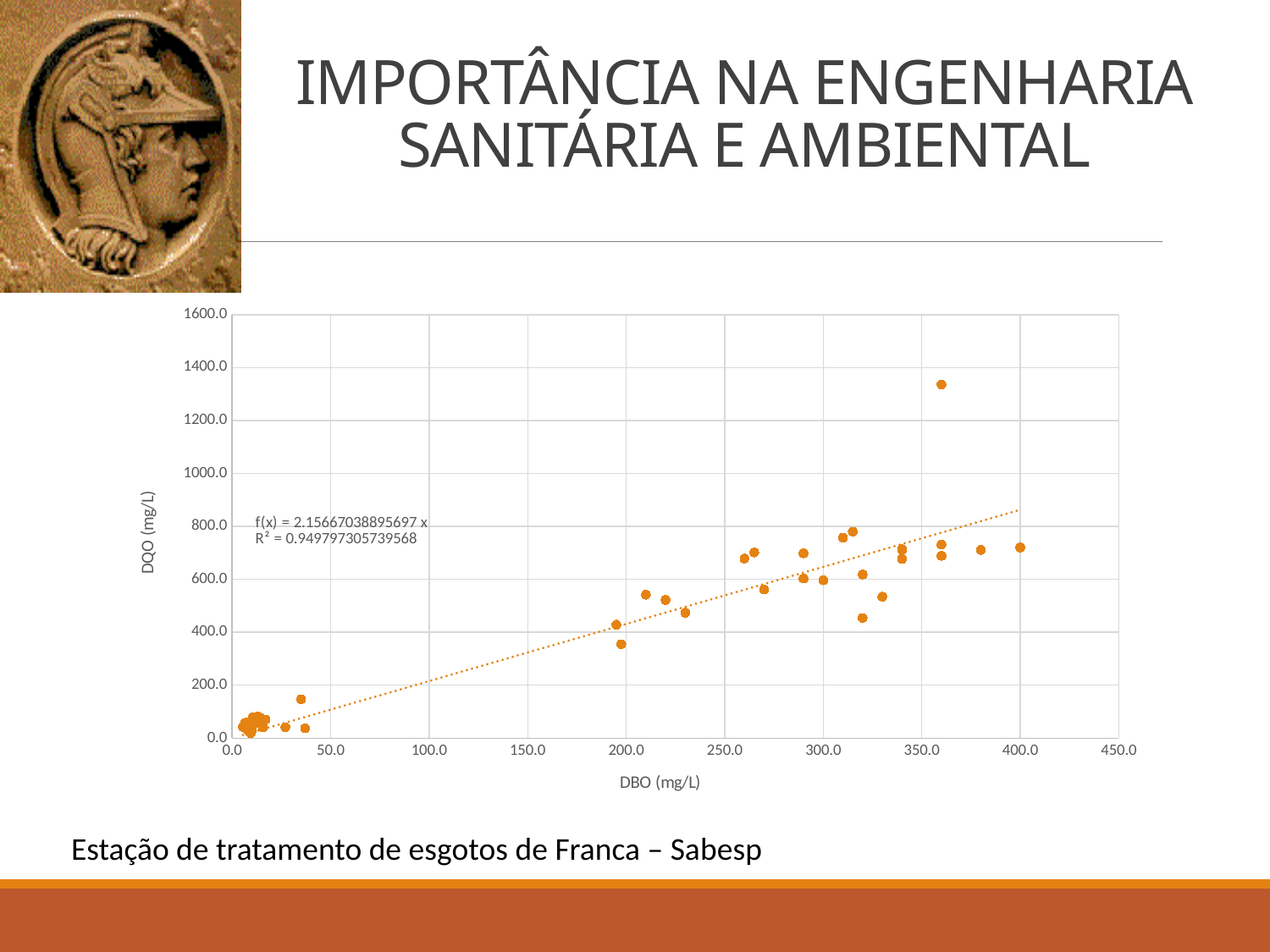
Is the DQO value of the point at DBO 400.0 greater or less than 600? greater Is the DQO value of the highest point on the chart greater or less than 1200? greater Which point has the higher DQO value: the point at DBO 400.0 or the highest point near DBO 360.0? The point near DBO 360.0 What kind of chart is shown on the slide? Scatter chart Is the DQO value of the point at DBO 400.0 greater or less than 800? less Do the DQO values generally rise or fall as DBO increases along the x axis? Rise What is the label of the y axis of the chart? DQO (mg/L) What is the maximum value shown on the y axis? 1600.0 What is the label of the x axis of the chart? DBO (mg/L)